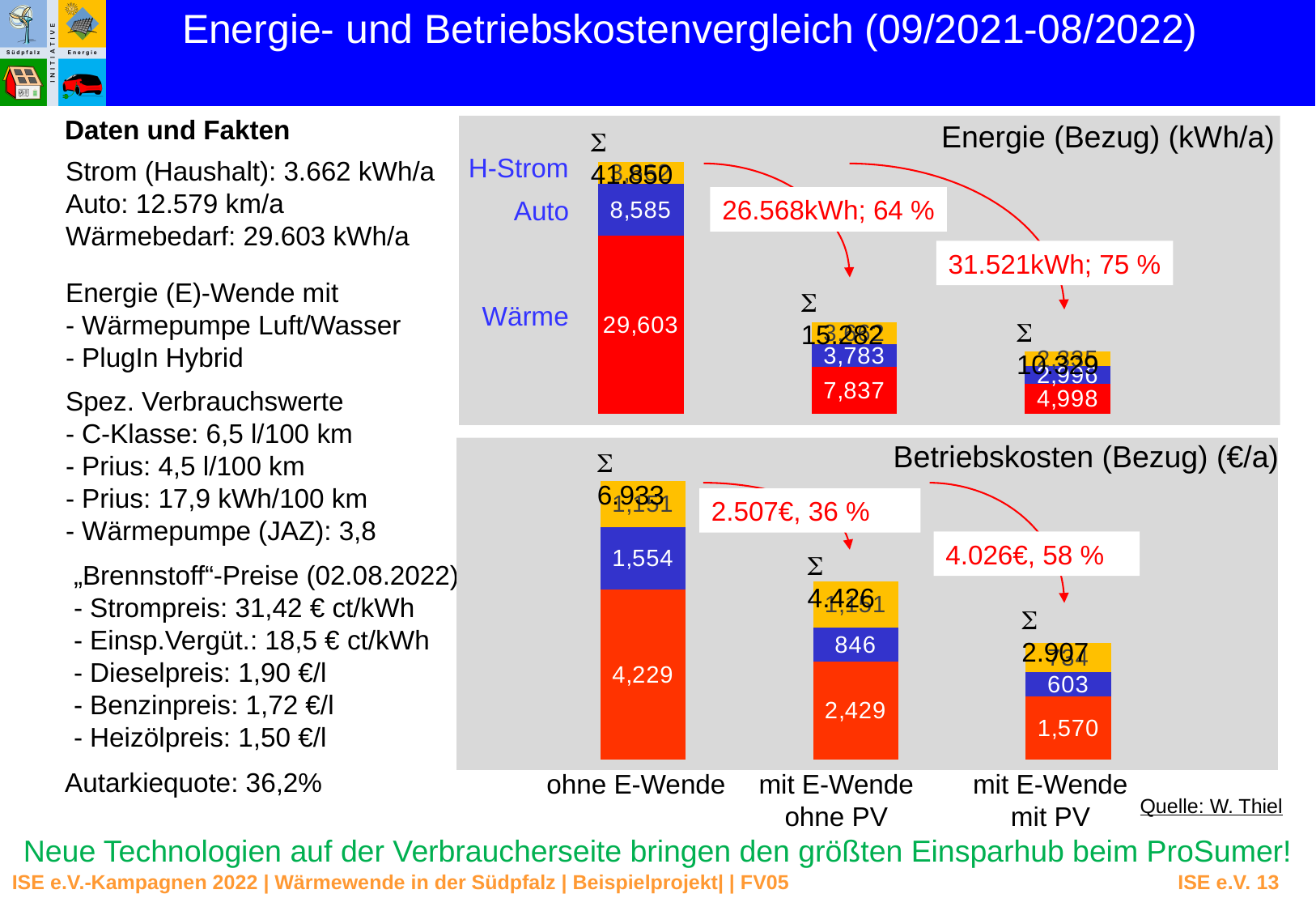
In the Betriebskosten (Bezug) (€/a) chart, what is the Auto value for mit E-Wende mit PV? 603 In the Energie (Bezug) (kWh/a) chart, what is the Auto value for mit E-Wende ohne PV? 3,783 In the Energie (Bezug) (kWh/a) chart, what is the Auto value for ohne E-Wende? 8,585 In the Energie (Bezug) (kWh/a) chart, do the Wärme values rise or fall from ohne E-Wende to mit E-Wende mit PV? fall In the Betriebskosten (Bezug) (€/a) chart, which is larger: the Wärme value for mit E-Wende ohne PV or the Wärme value for mit E-Wende mit PV? mit E-Wende ohne PV In the Energie (Bezug) (kWh/a) chart, what is the Wärme value for mit E-Wende mit PV? 4,998 In the Betriebskosten (Bezug) (€/a) chart, what is the difference between the Wärme value for ohne E-Wende and the Wärme value for mit E-Wende mit PV? 2,659 What kind of chart is the Energie (Bezug) (kWh/a) chart? stacked bar chart In the Energie (Bezug) (kWh/a) chart, what is the Wärme value for ohne E-Wende? 29,603 In the Energie (Bezug) (kWh/a) chart, which category has the highest Wärme value? ohne E-Wende How many categories are shown on the x axis of the Betriebskosten (Bezug) (€/a) chart? 3 In the Betriebskosten (Bezug) (€/a) chart, what is the Wärme value for ohne E-Wende? 4,229